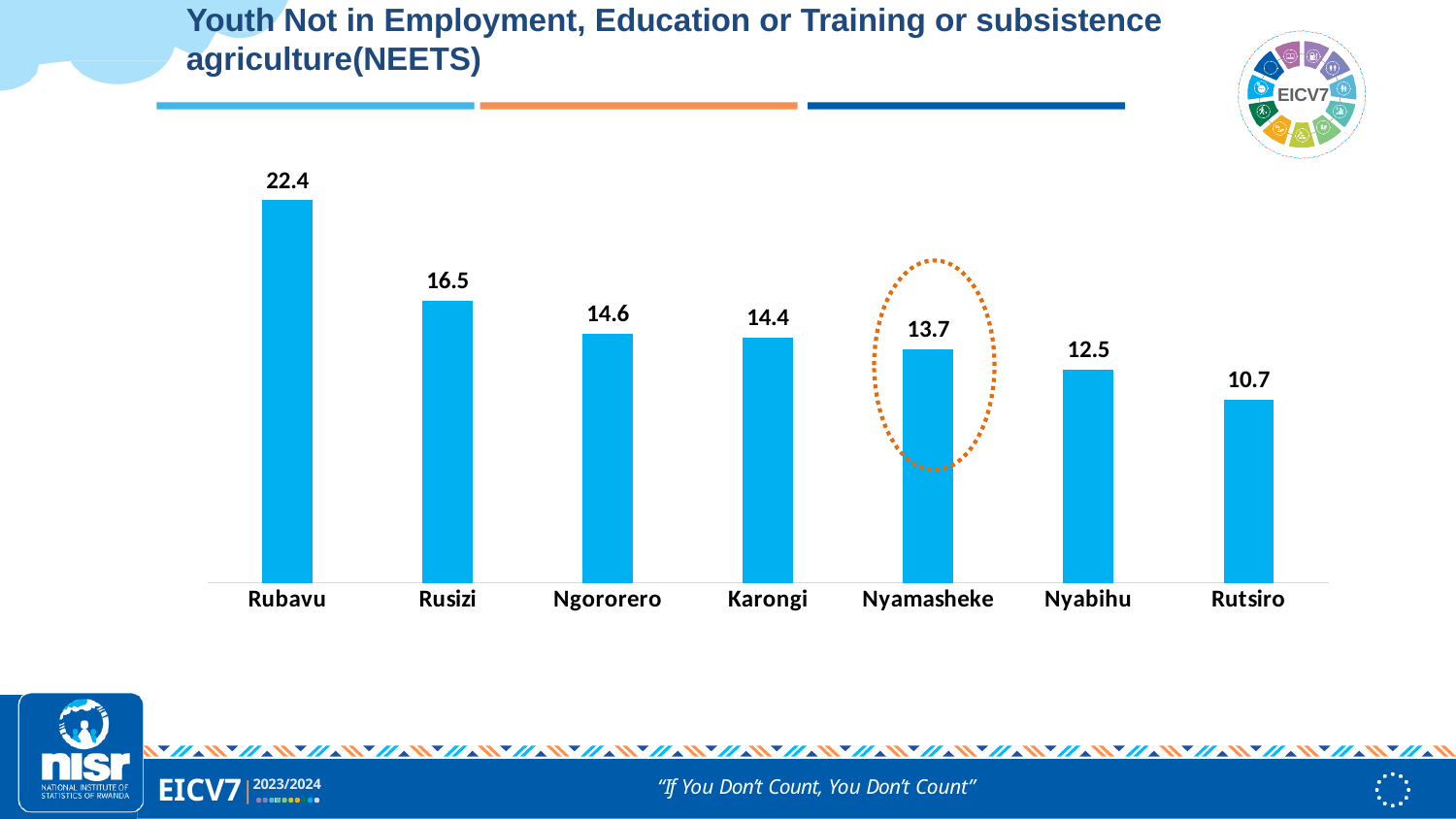
Which district has the highest value? Rubavu What is the difference between the values for Rubavu and Rusizi? 5.9 What is the value for Rutsiro? 10.7 What is the value for Nyamasheke? 13.7 Which is larger, the value for Rusizi or the value for Nyabihu? Rusizi How many districts are shown in the chart? 7 What is the value for Nyabihu? 12.5 What is the difference between the values for Nyamasheke and Rutsiro? 3.0 What is the value for Rubavu? 22.4 What kind of chart is shown on the slide? Bar chart Which district's bar is highlighted with a dotted orange circle? Nyamasheke Which district has the lowest value? Rutsiro